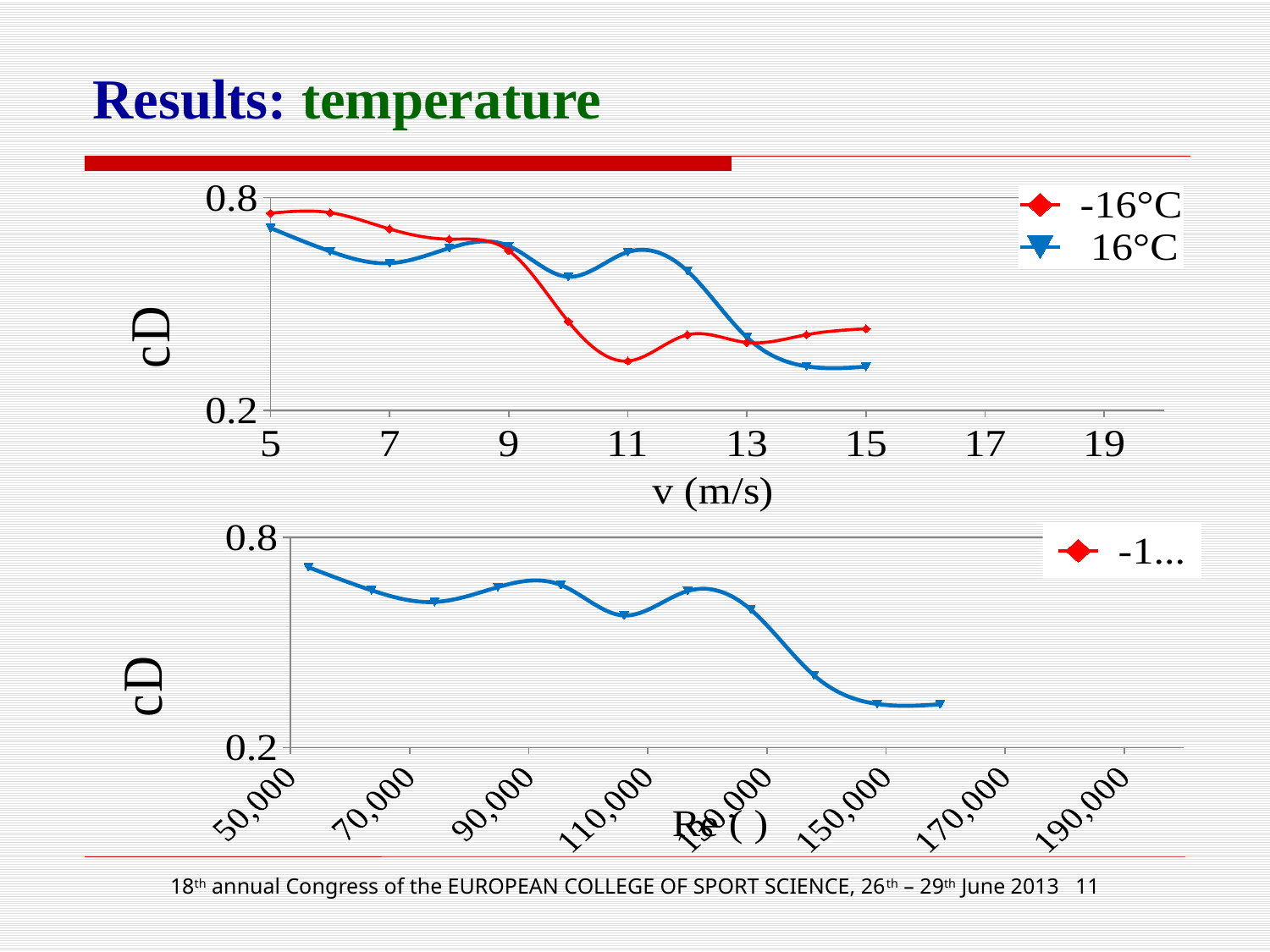
In the bottom chart, do the cD values generally rise or fall as Re increases? fall In the top chart, at v = 15 m/s, which series has the larger cD value, -16°C or 16°C? -16°C What kind of chart is the top chart (cD versus v (m/s))? line chart In the top chart, how many data points does the -16°C series have? 11 How many series does the legend of the top chart list? 2 In the top chart, at v = 11 m/s, which series has the larger cD value, -16°C or 16°C? 16°C In the top chart, is the cD value of the 16°C series at v = 5 m/s greater or less than 0.8? less In the top chart, do the cD values of the -16°C series generally rise or fall as v increases? fall What kind of chart is the bottom chart (cD versus Re)? line chart What are the two legend entries of the top chart? -16°C and 16°C In the top chart, at which v value does the -16°C series reach its lowest cD? 11 In the top chart, what is the label of the x axis? v (m/s)